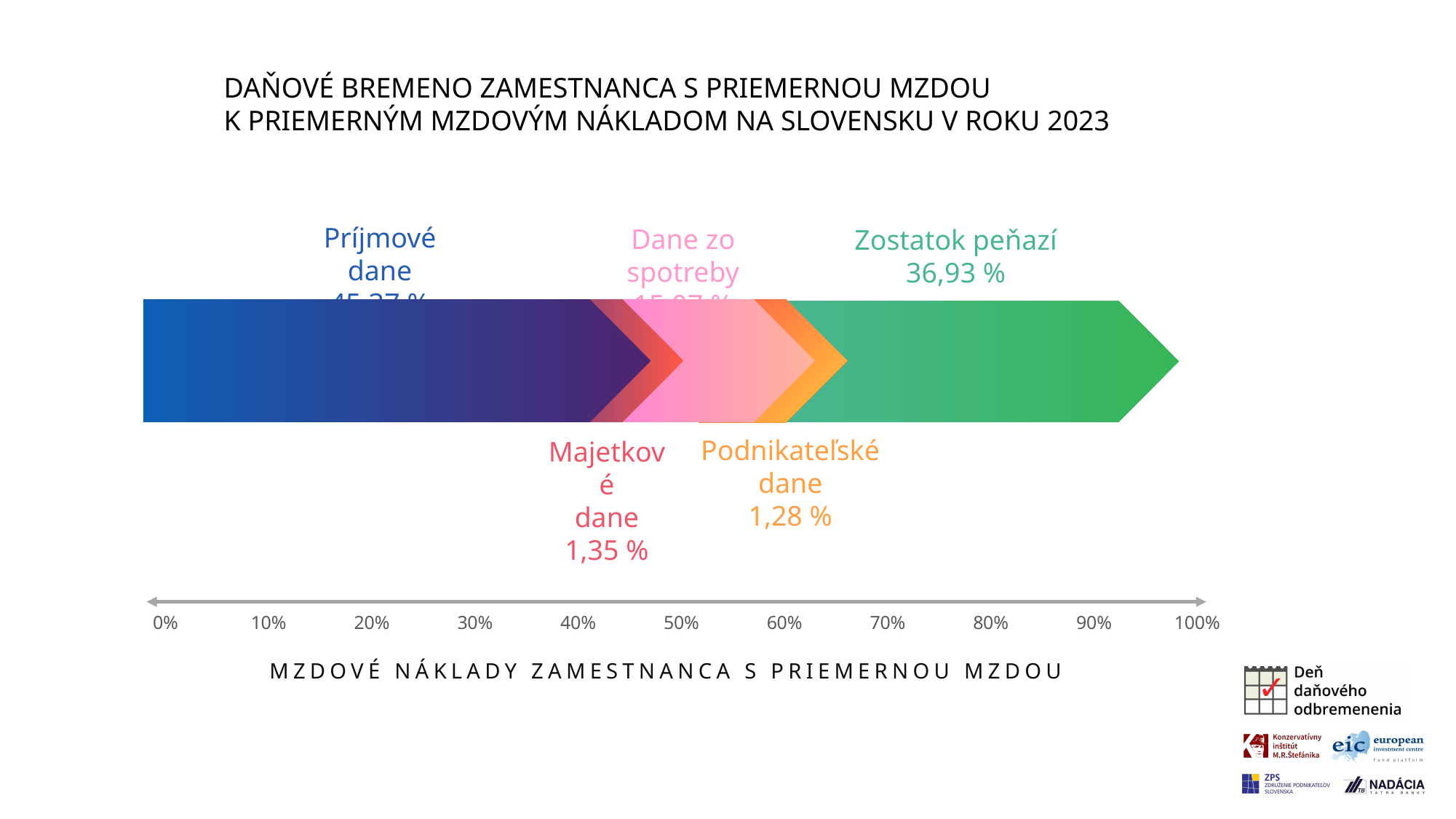
What is the value shown for Zostatok peňazí? 36,93 % Which is larger, Majetkové dane or Podnikateľské dane? Majetkové dane What is the difference between Majetkové dane and Podnikateľské dane? 0,07 % What is the value shown for Podnikateľské dane? 1,28 % Which segment of the bar is the smallest? Podnikateľské dane What is the value shown for Majetkové dane? 1,35 % Which segment of the bar is the largest? Príjmové dane What kind of chart is shown on the slide? Bar chart What is the label on the horizontal axis of the chart? MZDOVÉ NÁKLADY ZAMESTNANCA S PRIEMERNOU MZDOU How many segments make up the bar? 5 Is the value for Príjmové dane greater or less than 40%? greater Is the value for Zostatok peňazí greater or less than 50%? less